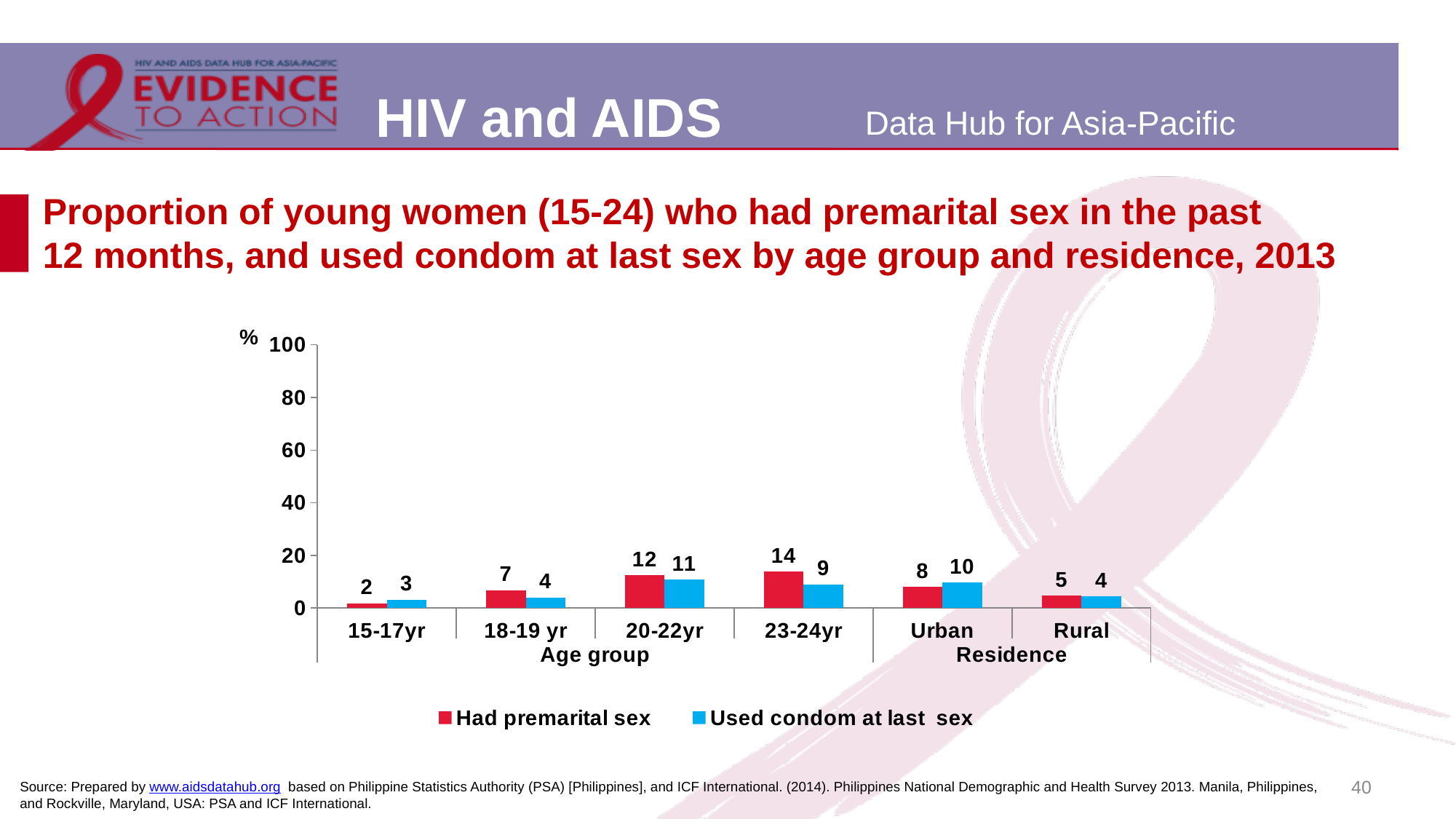
What is the value for 'Had premarital sex' in the 15-17yr age group? 2 Across the four age groups, does the value for 'Had premarital sex' rise or fall from 15-17yr to 23-24yr? Rise Which age group has the highest value for 'Had premarital sex'? 23-24yr What is the value for 'Had premarital sex' in the 23-24yr age group? 14 How many series does the legend list? 2 Which category has the lowest value for 'Used condom at last sex'? 15-17yr What is the difference between 'Had premarital sex' and 'Used condom at last sex' for the 23-24yr age group? 5 How many categories are shown on the x axis? 6 What kind of chart is shown on the slide? Bar chart Is the value for 'Had premarital sex' in the 20-22yr age group greater or less than 20? less Which is larger for Urban residence: 'Had premarital sex' or 'Used condom at last sex'? Used condom at last sex What is the value for 'Used condom at last sex' among Urban young women? 10